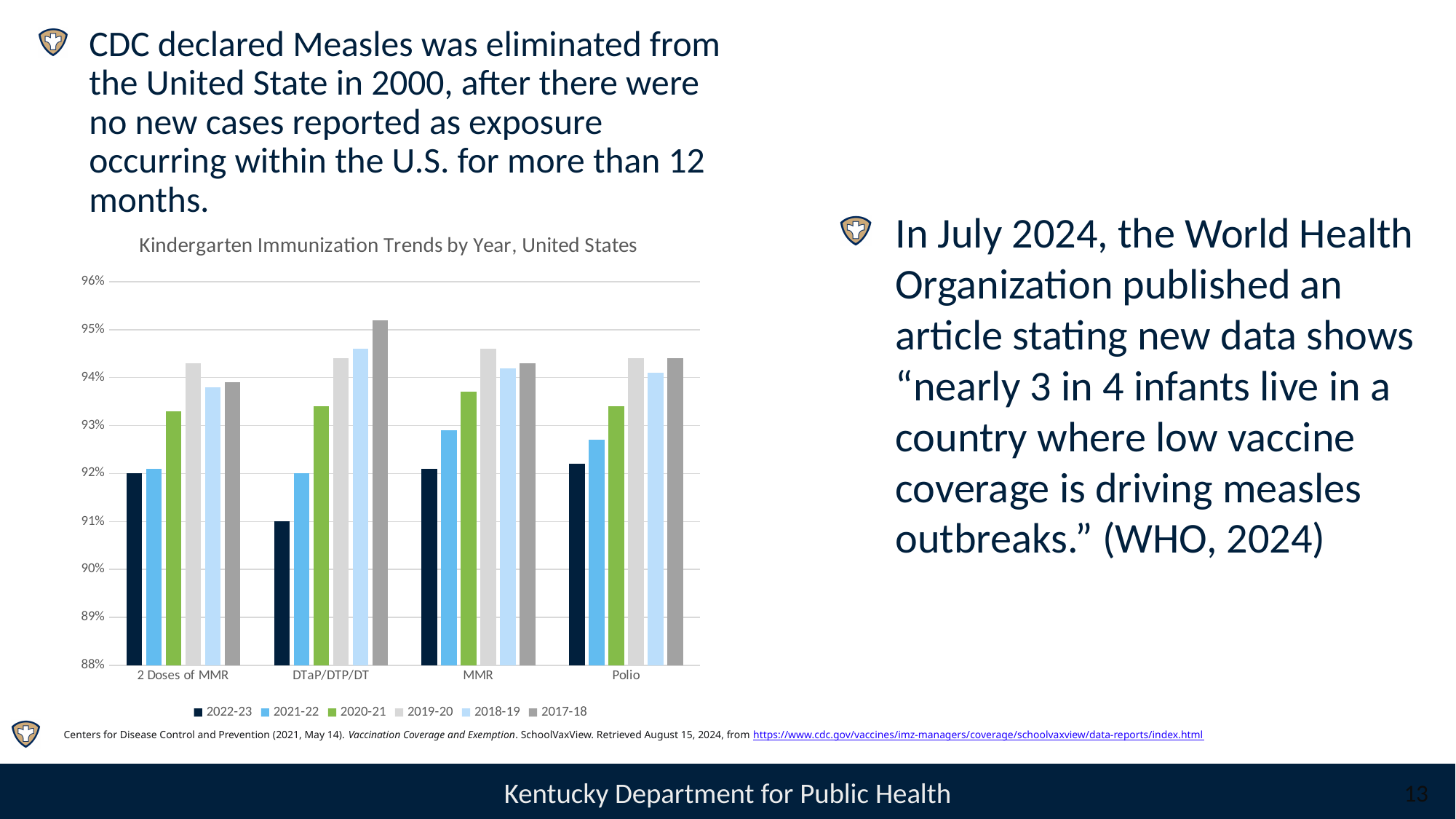
How many vaccine categories are shown on the x axis of the chart? 4 Is the 2022-23 value for DTaP/DTP/DT greater or less than 92%? less Is the 2022-23 value for Polio greater or less than 93%? less For 2 Doses of MMR, which is larger: the 2020-21 value or the 2021-22 value? 2020-21 Within the DTaP/DTP/DT group, which school year has the highest value? 2017-18 What colour represents the 2020-21 series in the chart? green Is the 2017-18 value for DTaP/DTP/DT greater or less than 94%? greater What is the title of the chart? Kindergarten Immunization Trends by Year, United States What kind of chart is shown on the slide? bar chart Within the DTaP/DTP/DT group, which school year has the lowest value? 2022-23 Within the DTaP/DTP/DT group, do the values for more recent school years rise or fall compared with the earlier school years? fall How many series does the legend of the chart list? 6